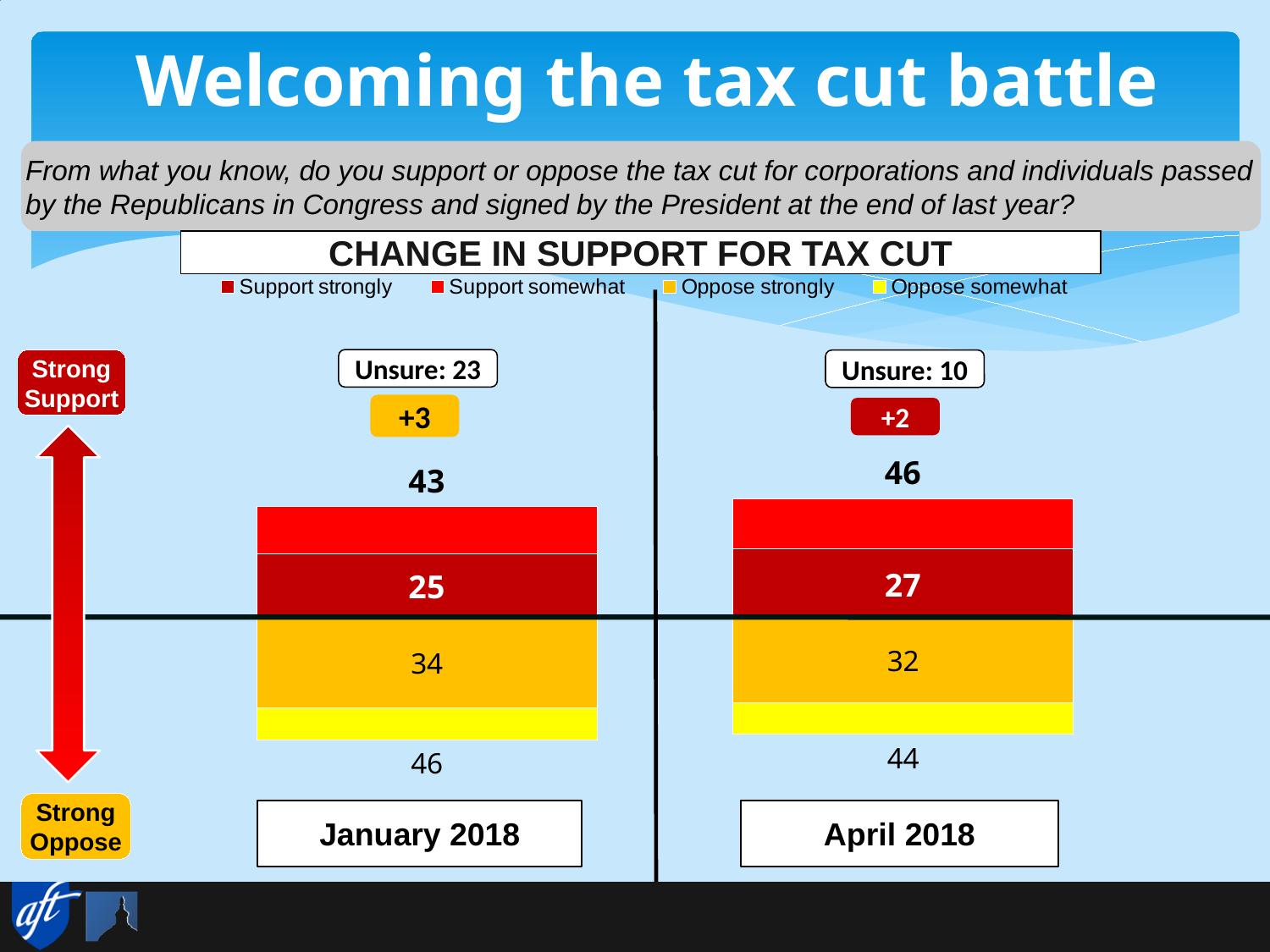
What is the total oppose figure shown below the January 2018 bar? 46 What is the total support figure shown above the April 2018 bar? 46 What is the "Unsure" figure shown for January 2018? Unsure: 23 What kind of chart is shown under the title "CHANGE IN SUPPORT FOR TAX CUT"? Stacked bar chart What is the "Oppose strongly" value for April 2018? 32 By how much did the "Support strongly" value change from January 2018 to April 2018? 2 What is the "Support strongly" value for April 2018? 27 How many time periods (categories) are plotted in the chart? 2 What is the "Support strongly" value for January 2018? 25 Which period has the higher "Oppose strongly" value, January 2018 or April 2018? January 2018 What is the "Oppose strongly" value for January 2018? 34 How many series does the legend of the chart list? 4